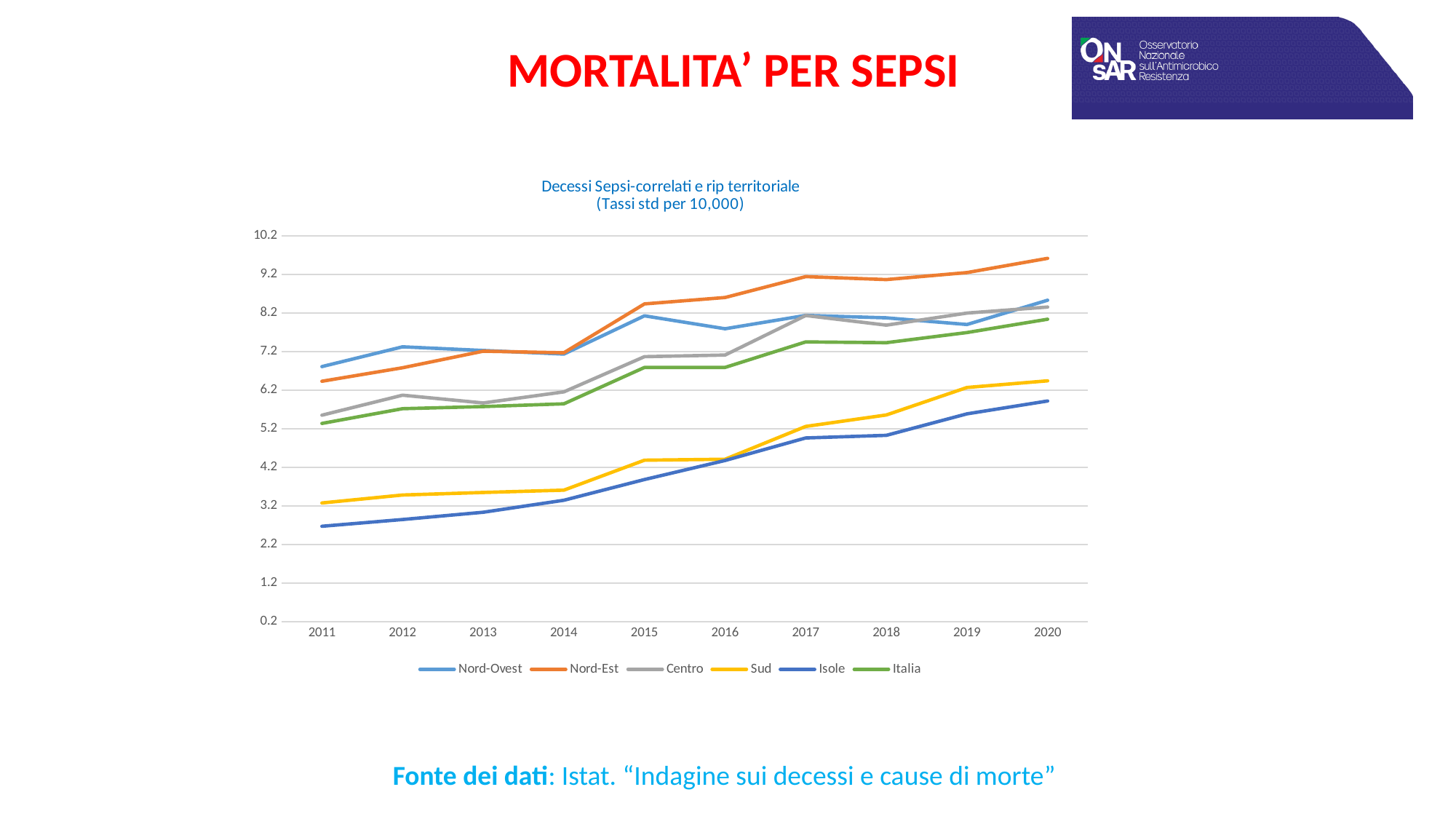
How many years are shown on the x axis? 10 Which series has the lowest value in 2020? Isole What kind of chart is shown on the slide? line chart Do the values for Isole rise or fall from 2011 to 2020? rise Is the value for Nord-Est in 2020 greater or less than 9.2? greater Which series has the lowest value in 2011? Isole How many series does the legend list? 6 Which series has the highest value in 2020? Nord-Est Which series has the highest value in 2011? Nord-Ovest Is the value for Isole in 2011 greater or less than 3.2? less Which is larger in 2017, the value for Nord-Est or the value for Sud? Nord-Est What is the title of the chart? Decessi Sepsi-correlati e rip territoriale (Tassi std per 10,000)